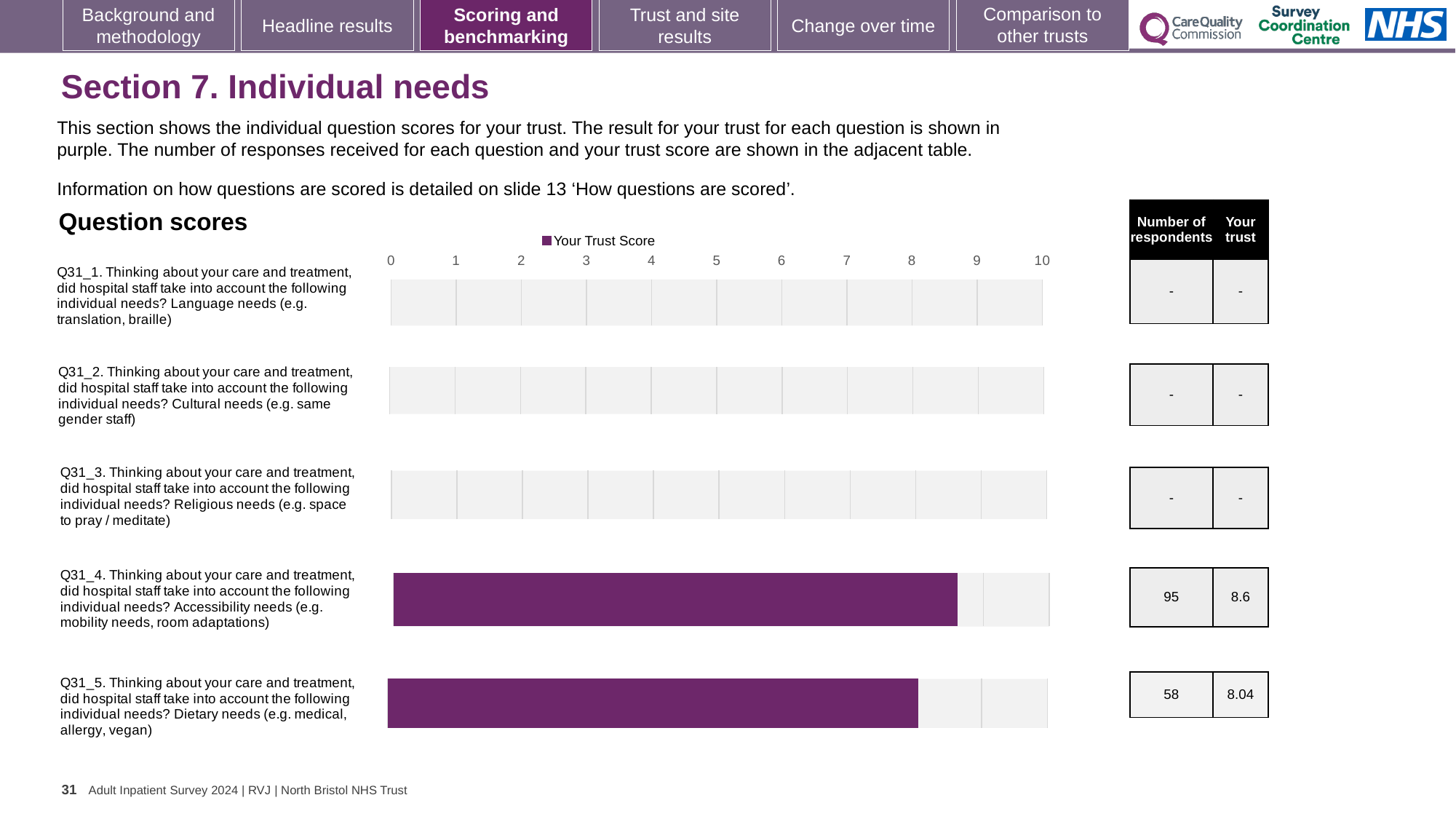
What is the difference between the trust scores for Q31_4 and Q31_5? 0.56 What is the trust score for Q31_4 (Accessibility needs)? 8.6 Is the trust score for Q31_5 (Dietary needs) greater or less than 9? less How many respondents answered Q31_4 (Accessibility needs)? 95 How many questions are listed in the Question scores chart? 5 How many series does the chart legend list? 1 What kind of chart is used to show the question scores? Bar chart Which question has the higher trust score, Q31_4 or Q31_5? Q31_4 What is the trust score for Q31_5 (Dietary needs)? 8.04 How many respondents answered Q31_5 (Dietary needs)? 58 What is the name of the series shown in the chart legend? Your Trust Score Is the trust score for Q31_4 (Accessibility needs) greater or less than 8? greater